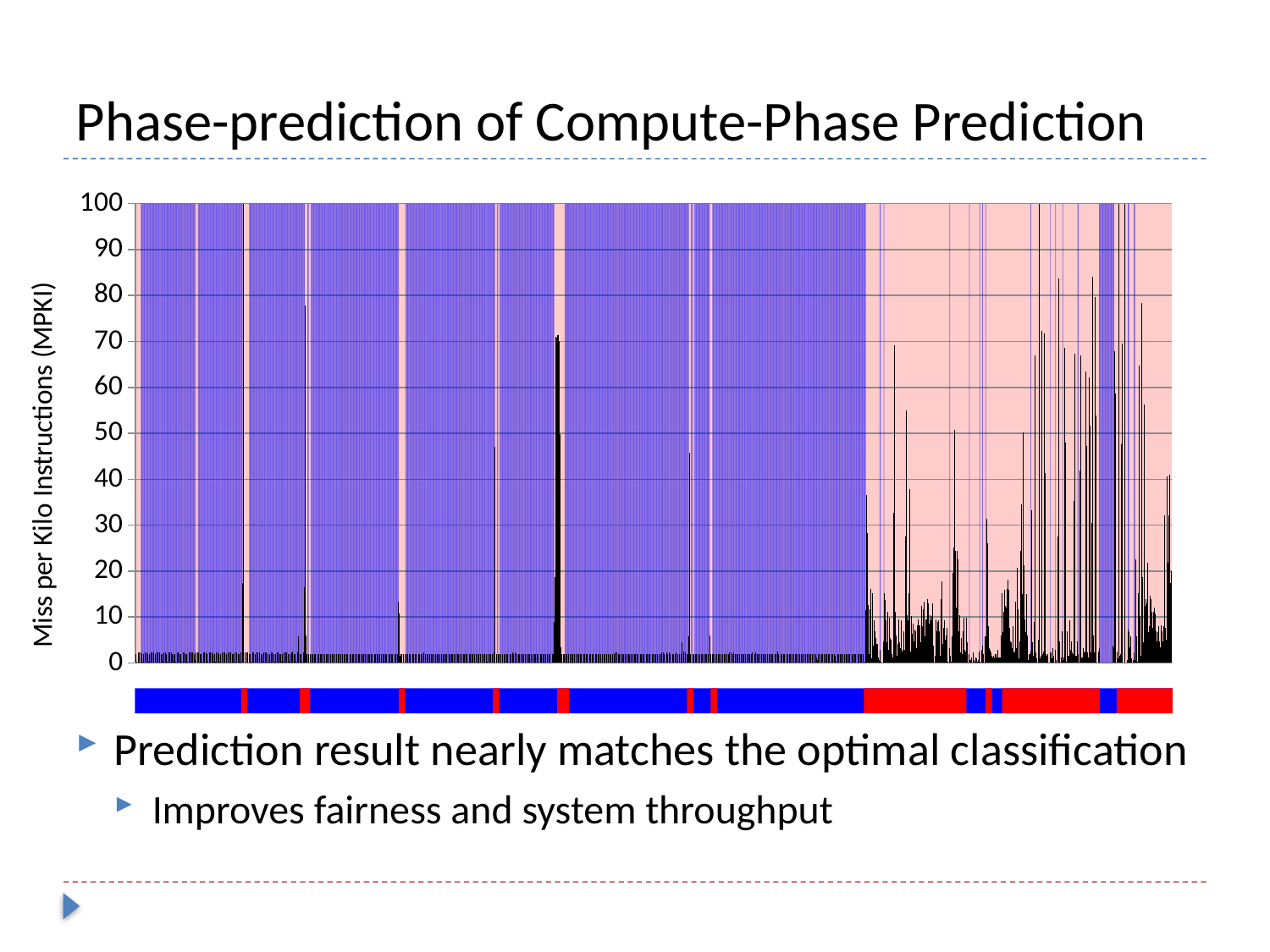
What is the interval between consecutive y-axis tick labels on the chart? 10 Is the tallest black spike in the left, blue-shaded region of the chart greater or less than 70? greater Is the tallest black spike in the right, pink-shaded region of the chart greater or less than 60? greater What is the label on the y-axis of the chart? Miss per Kilo Instructions (MPKI) Is the tall black spike near the middle of the chart (at the narrow pink stripe) greater or less than 50? greater What is the maximum value shown on the y-axis of the chart? 100 How many tick labels are shown on the y-axis of the chart? 11 Are the MPKI values generally higher in the blue-shaded region or in the pink-shaded region of the chart? pink-shaded region